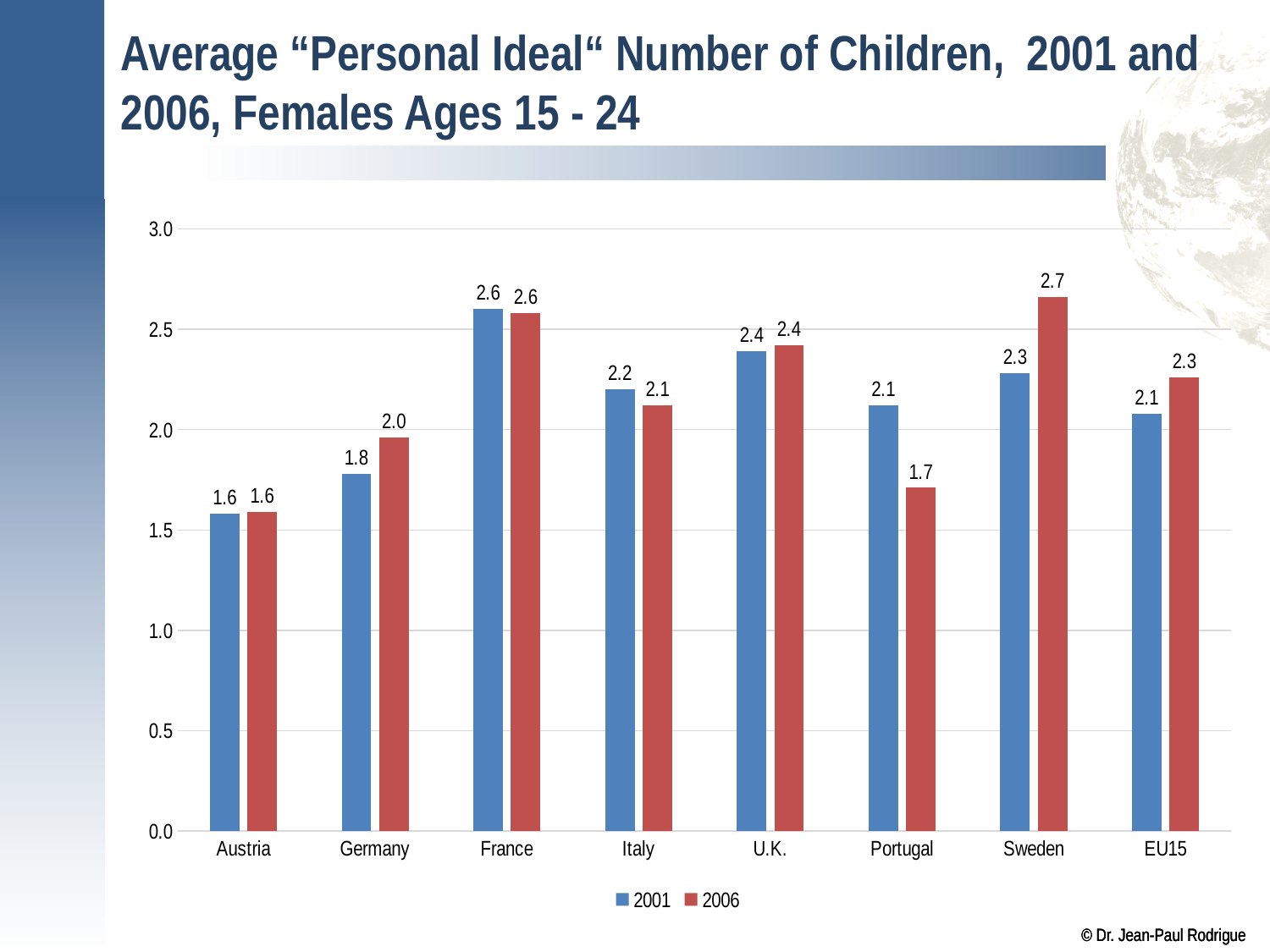
Is the 2001 value for Austria greater or less than 2.0? less What is the value for France in 2001? 2.6 Which country has the highest value in 2006? Sweden How many series does the legend list? 2 What is the difference between the 2006 and 2001 values for Germany? 0.2 Which is larger for Portugal, the 2001 value or the 2006 value? 2001 What is the difference between the 2001 and 2006 values for Portugal? 0.4 What kind of chart is shown on the slide? bar chart Which category has the lowest value in 2001? Austria What is the value for Portugal in 2006? 1.7 How many countries or regions are shown on the x axis? 8 What is the value for Sweden in 2006? 2.7